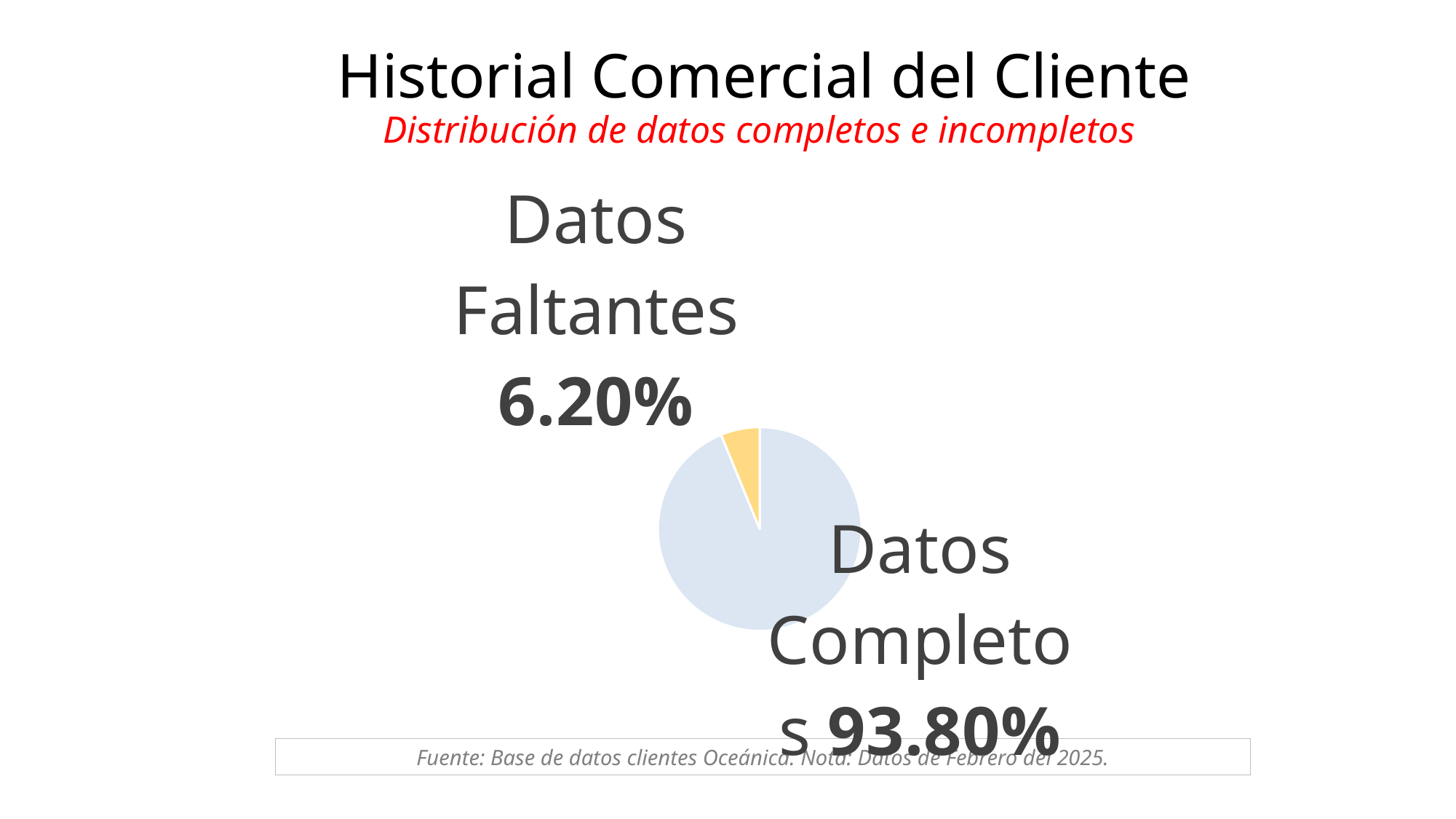
How many slices does the pie chart have? 2 What percentage is shown for Datos Faltantes? 6.20% What type of chart is shown on the slide? Pie chart What is the difference in percentage points between Datos Completos and Datos Faltantes? 87.60% What colour is the Datos Faltantes slice? Yellow Which slice of the pie is the smallest? Datos Faltantes What is the title of the slide containing the chart? Historial Comercial del Cliente What percentage is shown for Datos Completos? 93.80% Which is larger, Datos Faltantes or Datos Completos? Datos Completos What is the combined total of the two slices? 100% Which slice of the pie is the largest? Datos Completos